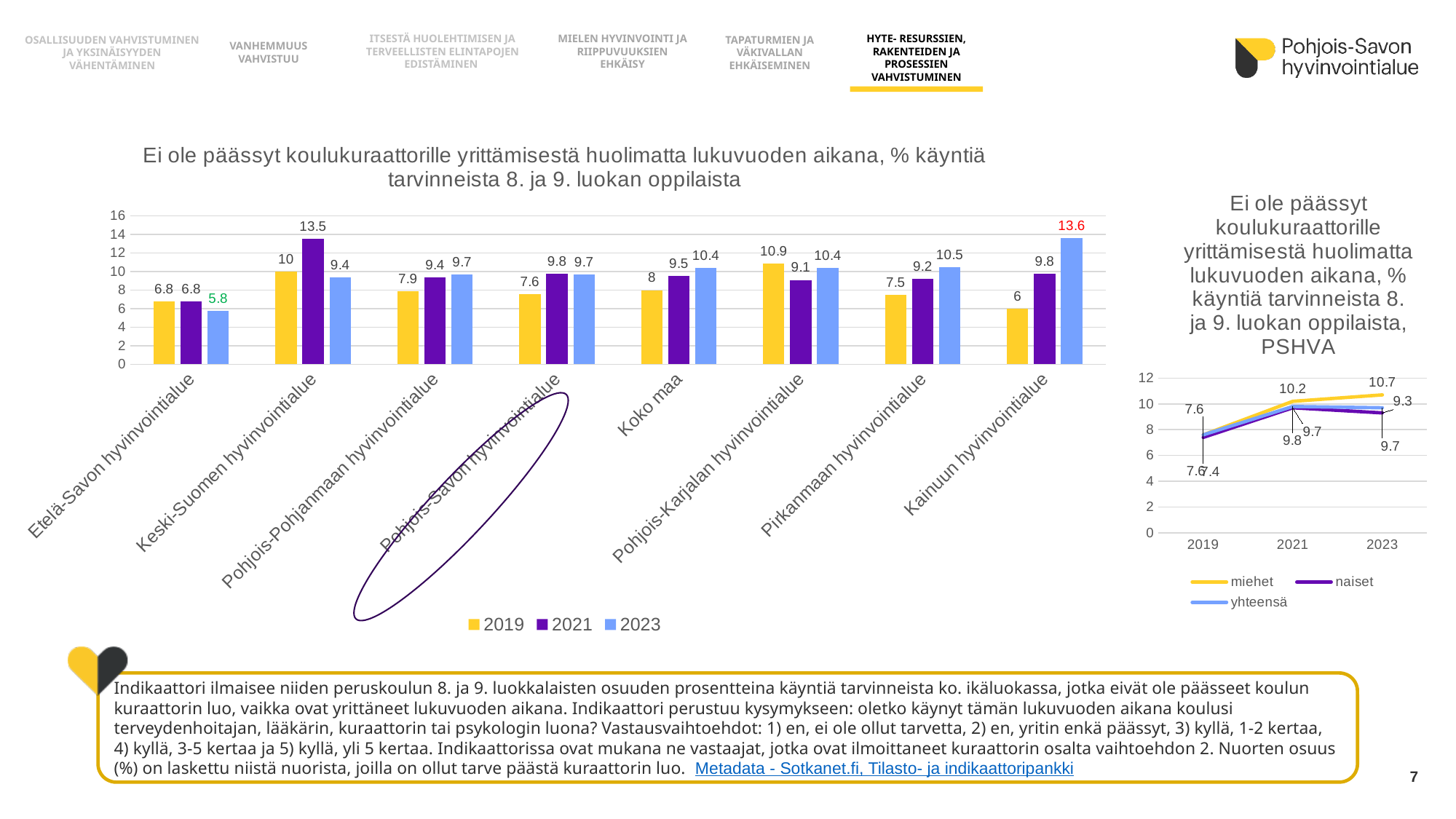
In the left bar chart, which category has the highest 2019 value? Pohjois-Karjalan hyvinvointialue In the left bar chart, what is the difference between the 2023 and 2019 values for Kainuun hyvinvointialue? 7.6 In the left bar chart, what is the 2021 value for Keski-Suomen hyvinvointialue? 13.5 In the left bar chart, which category has the lowest 2023 value? Etelä-Savon hyvinvointialue How many categories are shown on the x axis of the left bar chart? 8 How many series does the legend of the left bar chart list? 3 In the left bar chart, what is the 2023 value for Kainuun hyvinvointialue? 13.6 In the right line chart (PSHVA), does the miehet line rise or fall from 2019 to 2023? Rise In the left bar chart, which is larger for Koko maa: the 2021 value or the 2023 value? 2023 In the right line chart (PSHVA), what is the value for miehet in 2023? 10.7 What type of chart is the chart on the right side of the slide (PSHVA)? Line chart In the left bar chart, what is the 2019 value for Pohjois-Savon hyvinvointialue? 7.6